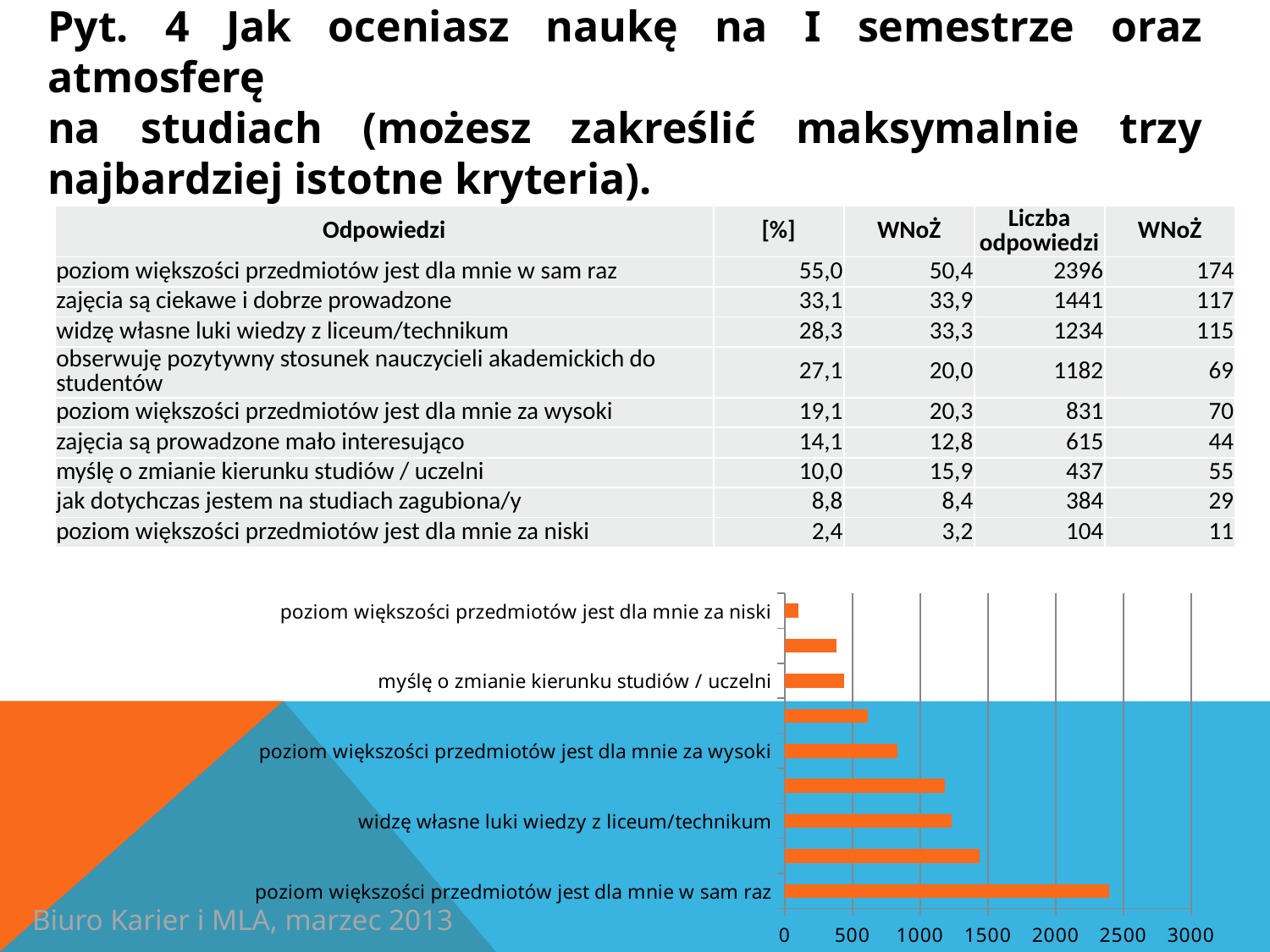
Is the value for 'myślę o zmianie kierunku studiów / uczelni' greater or less than 500? less What is the highest value shown on the chart's horizontal axis? 3000 Which category has the longest bar in the chart? poziom większości przedmiotów jest dla mnie w sam raz Do the bars get longer or shorter going from the top of the chart to the bottom? longer What kind of chart is shown at the bottom of the slide? bar chart Which bar is longer: 'poziom większości przedmiotów jest dla mnie w sam raz' or 'poziom większości przedmiotów jest dla mnie za wysoki'? poziom większości przedmiotów jest dla mnie w sam raz Is the value for 'poziom większości przedmiotów jest dla mnie w sam raz' greater or less than 2000? greater Is the value for 'poziom większości przedmiotów jest dla mnie za wysoki' greater or less than 500? greater How many bars are plotted in the chart? 9 Which category has the shortest bar in the chart? poziom większości przedmiotów jest dla mnie za niski